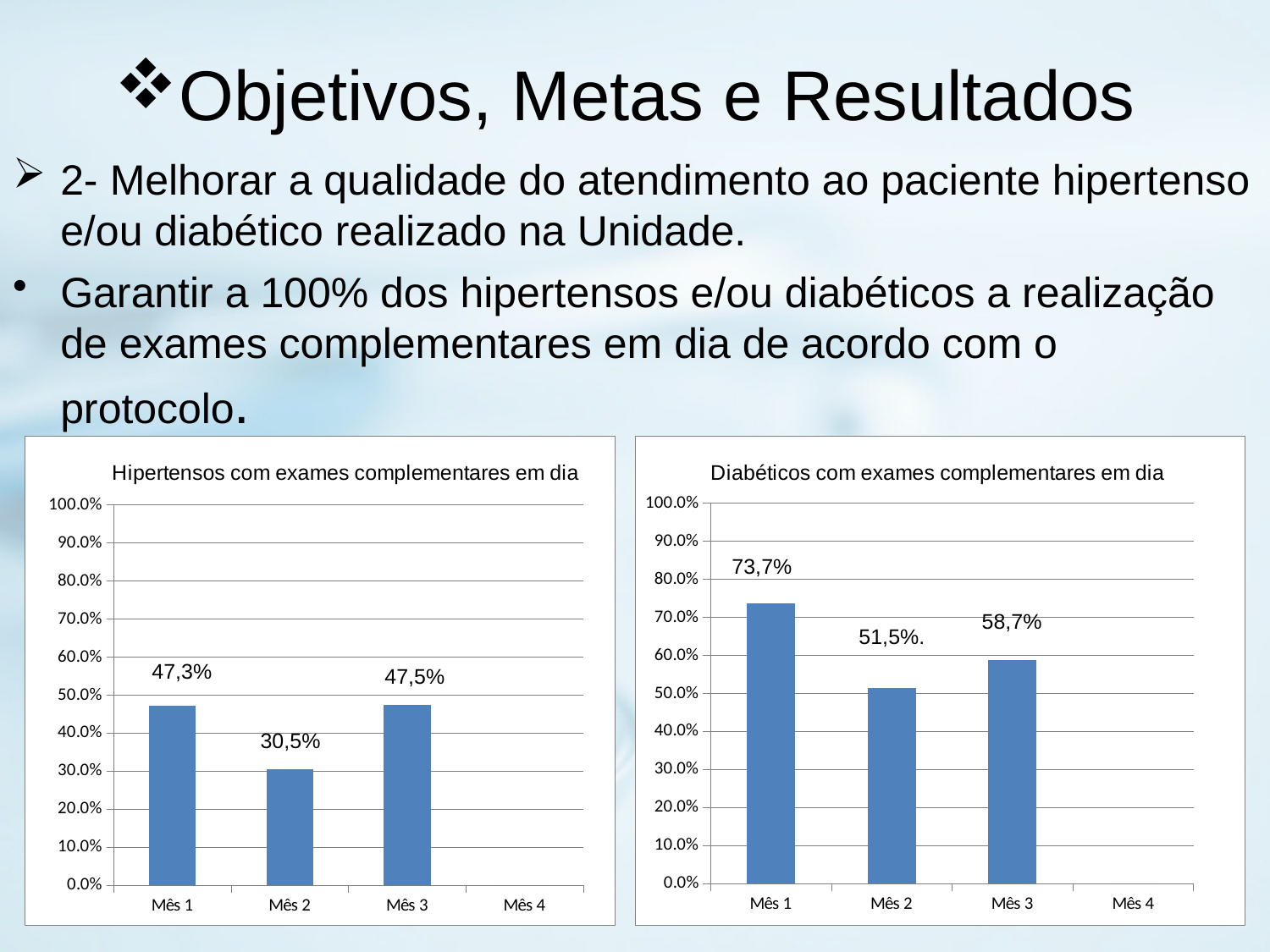
In the chart titled 'Diabéticos com exames complementares em dia', what is the difference between the values for Mês 1 and Mês 3? 15,0% In the chart titled 'Diabéticos com exames complementares em dia', which month has the highest value? Mês 1 In the chart titled 'Hipertensos com exames complementares em dia', is the value for Mês 1 greater or less than 50%? less In the chart titled 'Diabéticos com exames complementares em dia', how many month categories are shown on the x axis? 4 In the chart titled 'Hipertensos com exames complementares em dia', what is the value for Mês 1? 47,3% In the chart titled 'Hipertensos com exames complementares em dia', what is the value for Mês 2? 30,5% What kind of chart is the chart titled 'Hipertensos com exames complementares em dia'? bar chart In the chart titled 'Diabéticos com exames complementares em dia', which is larger, the value for Mês 2 or the value for Mês 3? Mês 3 In the chart titled 'Diabéticos com exames complementares em dia', what is the value for Mês 1? 73,7% In the chart titled 'Hipertensos com exames complementares em dia', what is the difference between the values for Mês 3 and Mês 2? 17,0% In the chart titled 'Diabéticos com exames complementares em dia', what is the value for Mês 3? 58,7%